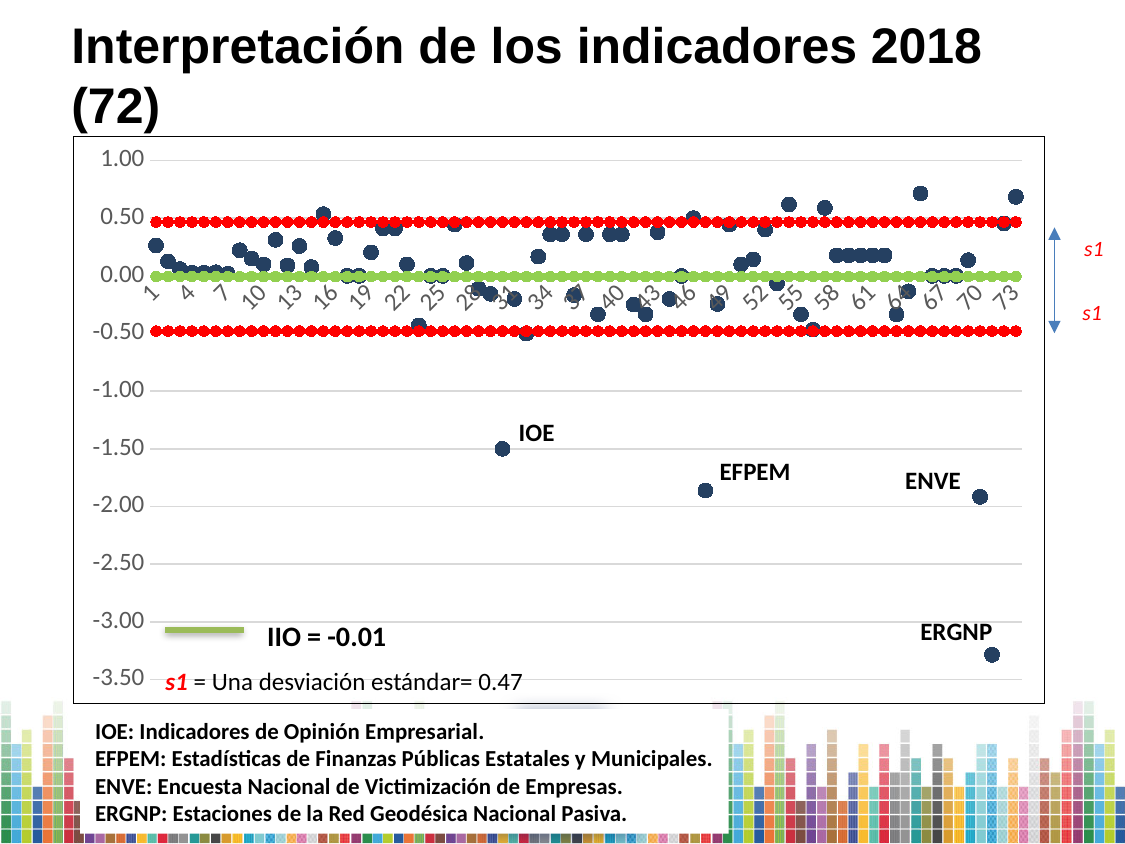
Which is lower, the point for IOE or the point for ERGNP? ERGNP Is the value for EFPEM greater or less than -1.50? less Which labeled point on the chart has the lowest value? ERGNP What is the value of one standard deviation (s1) shown on the chart? 0.47 What colour is the IIO line on the chart? green How many points on the chart are labeled with an indicator name? 4 What kind of chart is shown on the slide? scatter chart Which of the four labeled points (IOE, EFPEM, ENVE, ERGNP) has the highest value? IOE What is the value of IIO shown on the chart? -0.01 Is the value for ERGNP greater or less than -3.00? less Is the value for IOE greater or less than -1.00? less